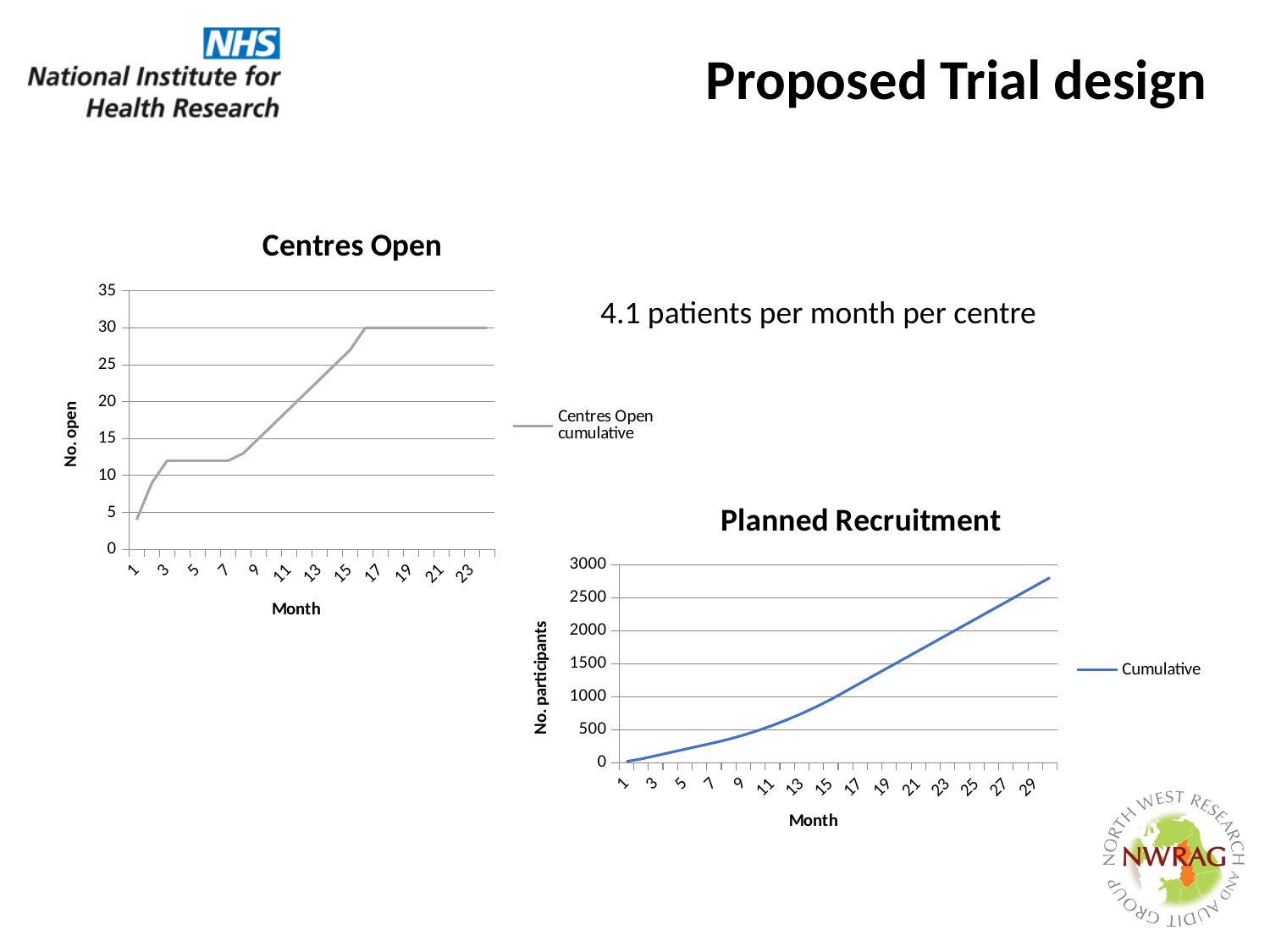
In the "Centres Open" chart, is the value at month 1 greater or less than 10? less In the "Planned Recruitment" chart, is the value at month 9 greater or less than 500? less In the "Centres Open" chart, is the value at month 23 greater or less than 25? greater What kind of chart is the "Centres Open" chart? line chart How many series does the legend of the "Planned Recruitment" chart list? 1 In the "Planned Recruitment" chart, which month has the highest cumulative value? 30 How many series does the legend of the "Centres Open" chart list? 1 In the "Planned Recruitment" chart, do the values rise or fall as the month increases? rise What is the name of the series shown in the "Planned Recruitment" chart's legend? Cumulative What is the y-axis label of the "Centres Open" chart? No. open What kind of chart is the "Planned Recruitment" chart? line chart